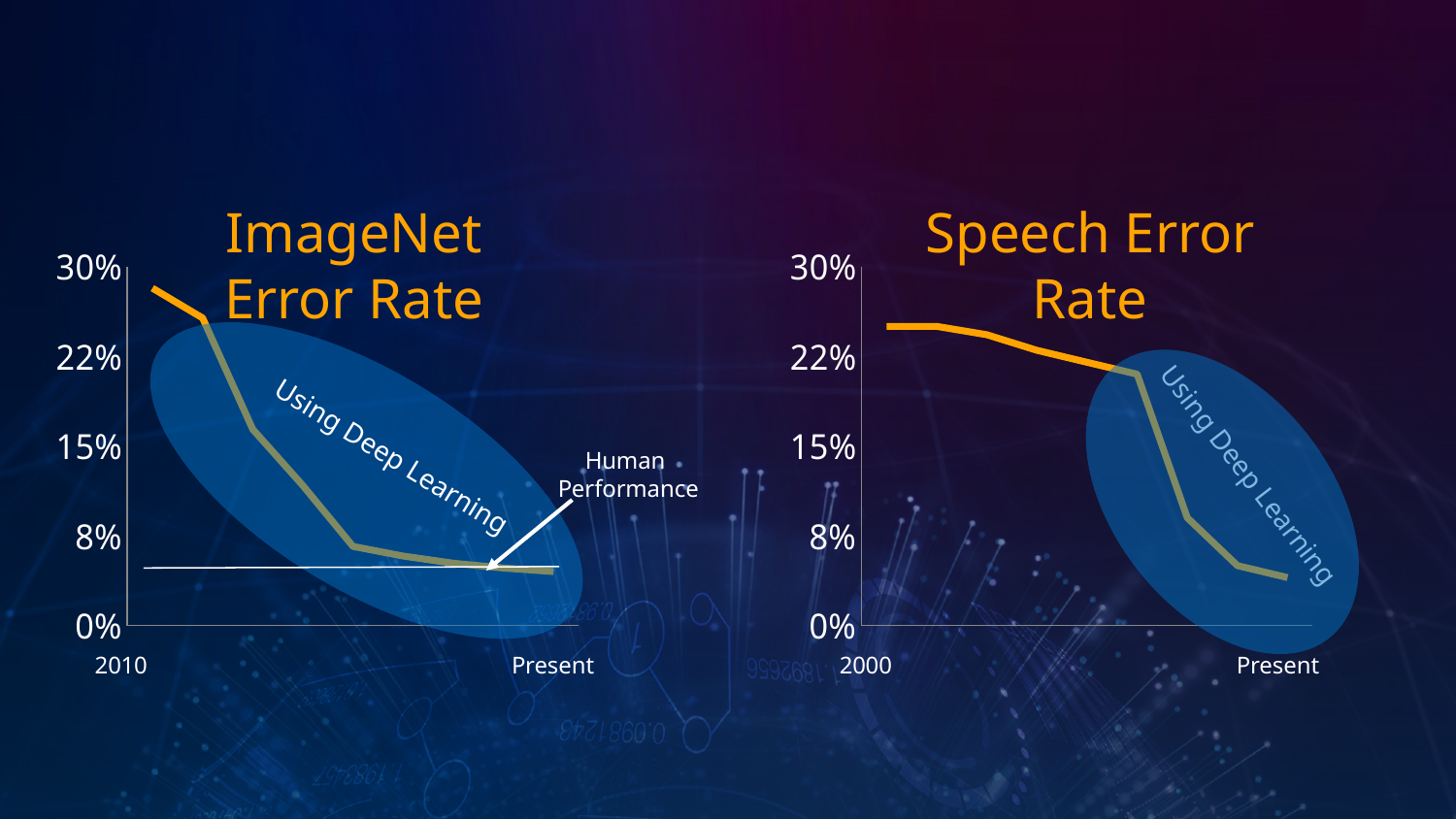
In the ImageNet Error Rate chart, what does the horizontal white line represent? Human Performance In the Speech Error Rate chart, is the error rate at 2000 greater or less than 22%? greater What kind of chart is the ImageNet Error Rate chart? line chart In the Speech Error Rate chart, does the error rate rise or fall from 2000 to Present? fall In the ImageNet Error Rate chart, is the Human Performance line greater or less than 8%? less In the Speech Error Rate chart, which is larger: the error rate at 2000 or at Present? 2000 In the Speech Error Rate chart, is the error rate at Present greater or less than 8%? less What kind of chart is the Speech Error Rate chart? line chart What is the title of the chart on the right side of the slide? Speech Error Rate In the ImageNet Error Rate chart, does the error rate rise or fall from 2010 to Present? fall